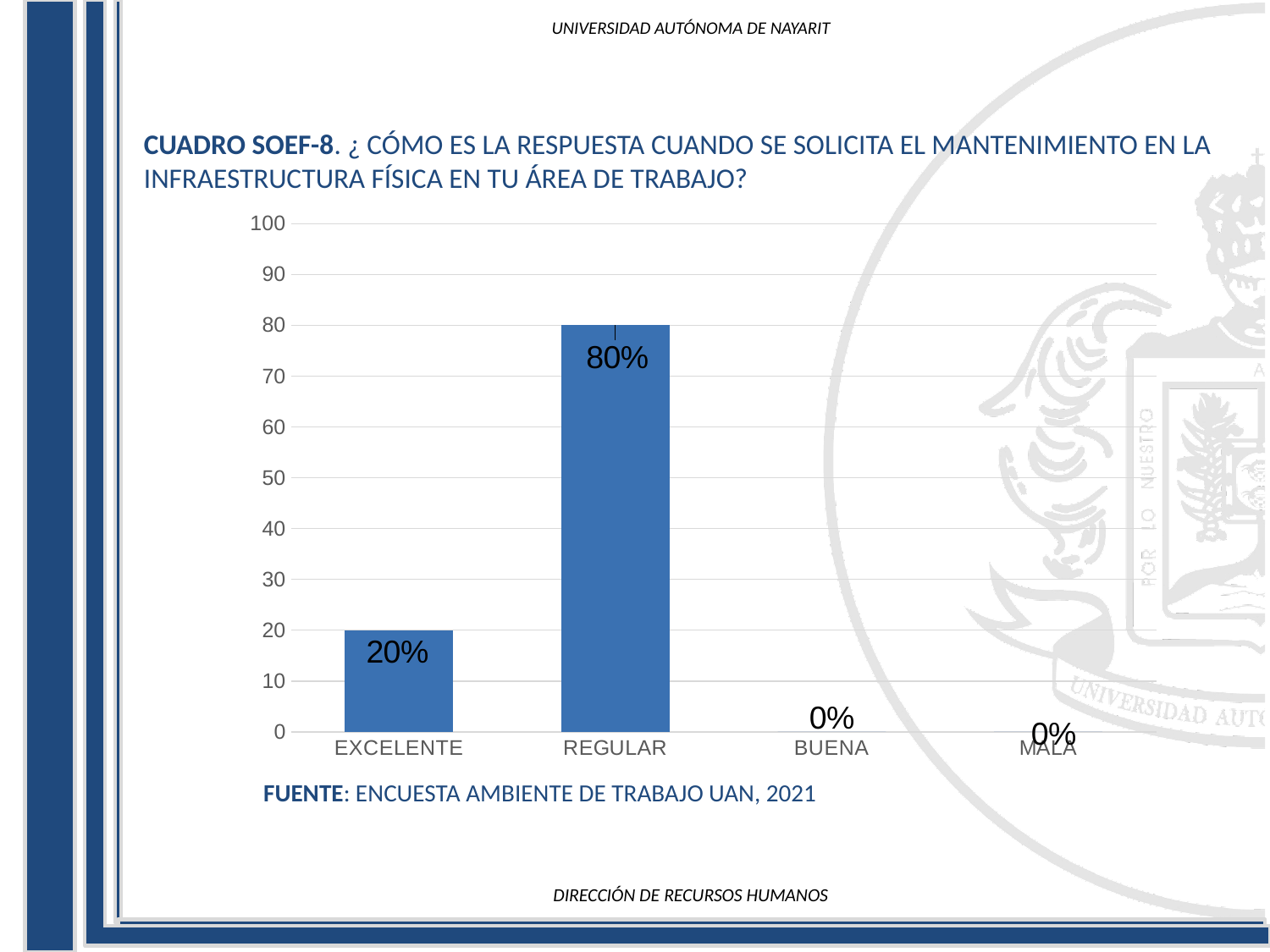
What source is cited below the chart? ENCUESTA AMBIENTE DE TRABAJO UAN, 2021 What kind of chart is shown on the slide? Bar chart What is the value for MALA? 0% What is the value for REGULAR? 80% Which category has the highest value? REGULAR What is the difference between the values for REGULAR and EXCELENTE? 60% Which is larger, the value for EXCELENTE or the value for REGULAR? REGULAR What is the value for EXCELENTE? 20% Is the value for EXCELENTE greater or less than 30? less Is the value for REGULAR greater or less than 50? greater What is the value for BUENA? 0% How many categories are shown on the x axis? 4